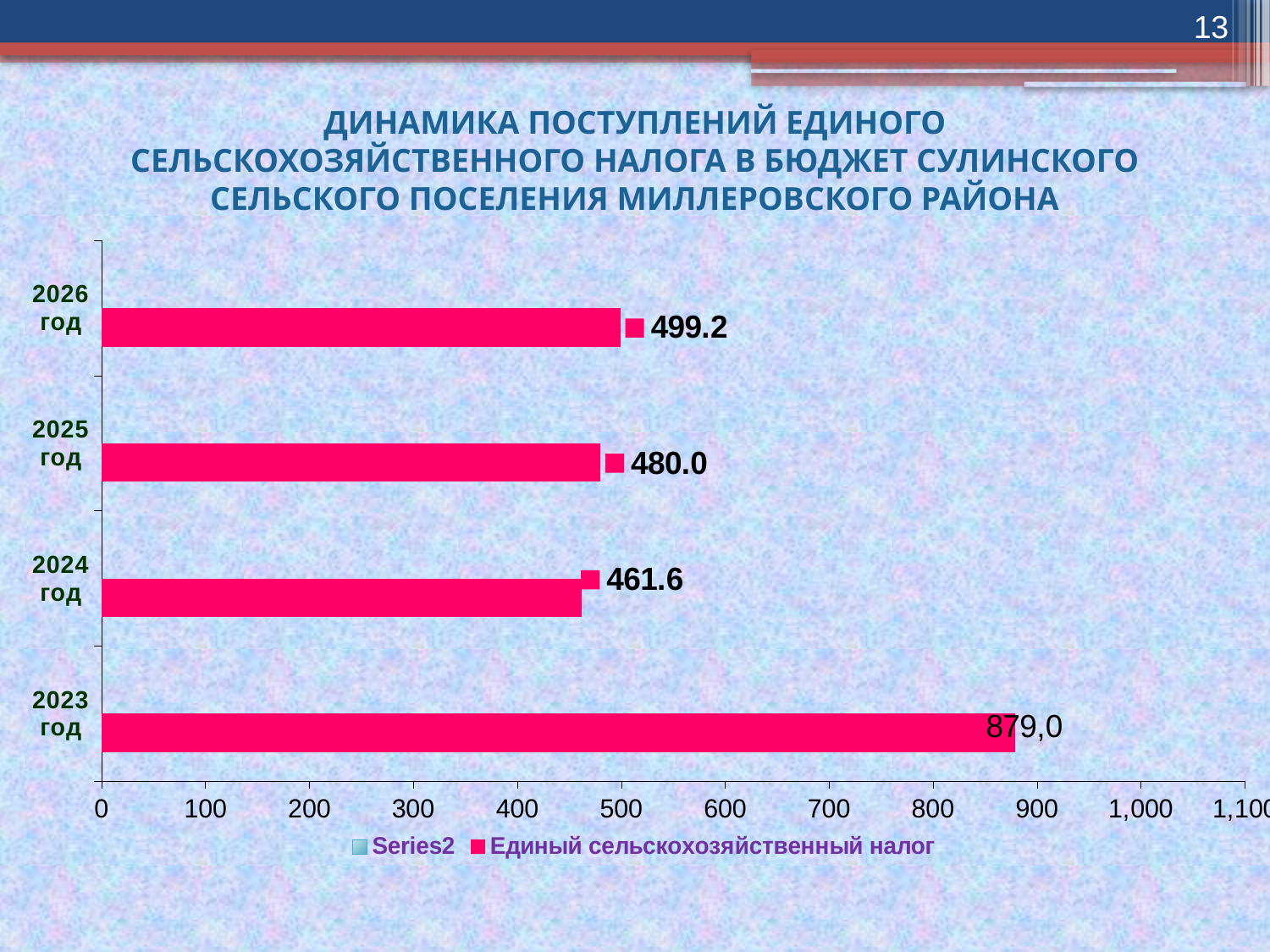
What is the value for 2024 год? 461.6 What is the difference between the values for 2025 год and 2024 год? 18.4 Which is larger, the value for 2025 год or the value for 2024 год? 2025 год Is the value for 2023 год greater or less than 800? greater How many years are shown on the chart? 4 Which year has the lowest value? 2024 год What is the value for 2026 год? 499.2 What is the difference between the values for 2026 год and 2025 год? 19.2 What kind of chart is shown on the slide? bar chart What is the value for 2023 год? 879,0 How many series does the legend list? 2 Which year has the highest value? 2023 год